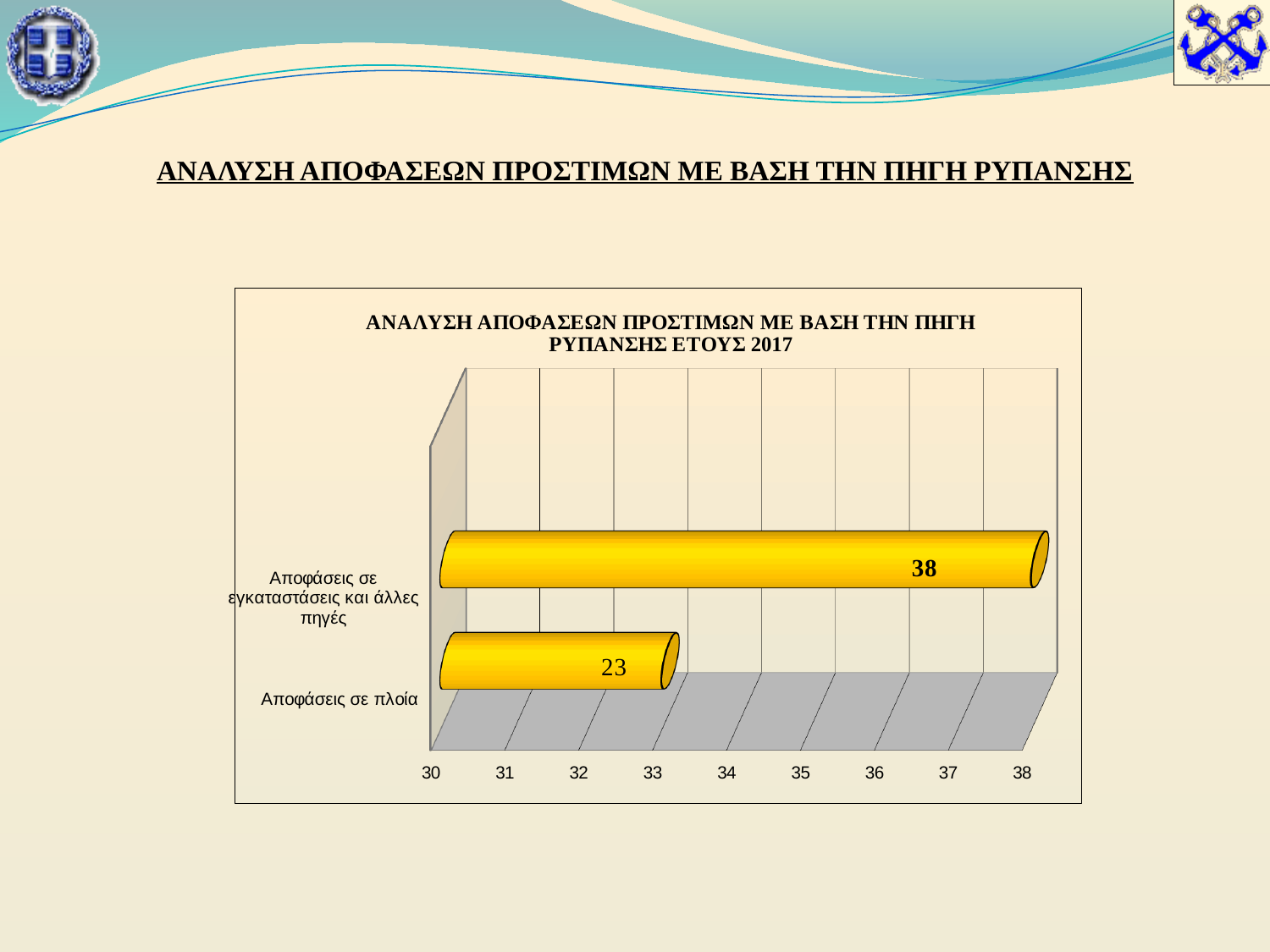
Which category has the lowest value? Αποφάσεις σε πλοία What is the title of the chart? ΑΝΑΛΥΣΗ ΑΠΟΦΑΣΕΩΝ ΠΡΟΣΤΙΜΩΝ ΜΕ ΒΑΣΗ ΤΗΝ ΠΗΓΗ ΡΥΠΑΝΣΗΣ ΕΤΟΥΣ 2017 What kind of chart is shown on the slide? Bar chart How many categories are shown in the chart? 2 What is the value for Αποφάσεις σε εγκαταστάσεις και άλλες πηγές? 38 What colour are the bars in the chart? Yellow Which category has the highest value? Αποφάσεις σε εγκαταστάσεις και άλλες πηγές Which is larger, the value for Αποφάσεις σε πλοία or the value for Αποφάσεις σε εγκαταστάσεις και άλλες πηγές? Αποφάσεις σε εγκαταστάσεις και άλλες πηγές